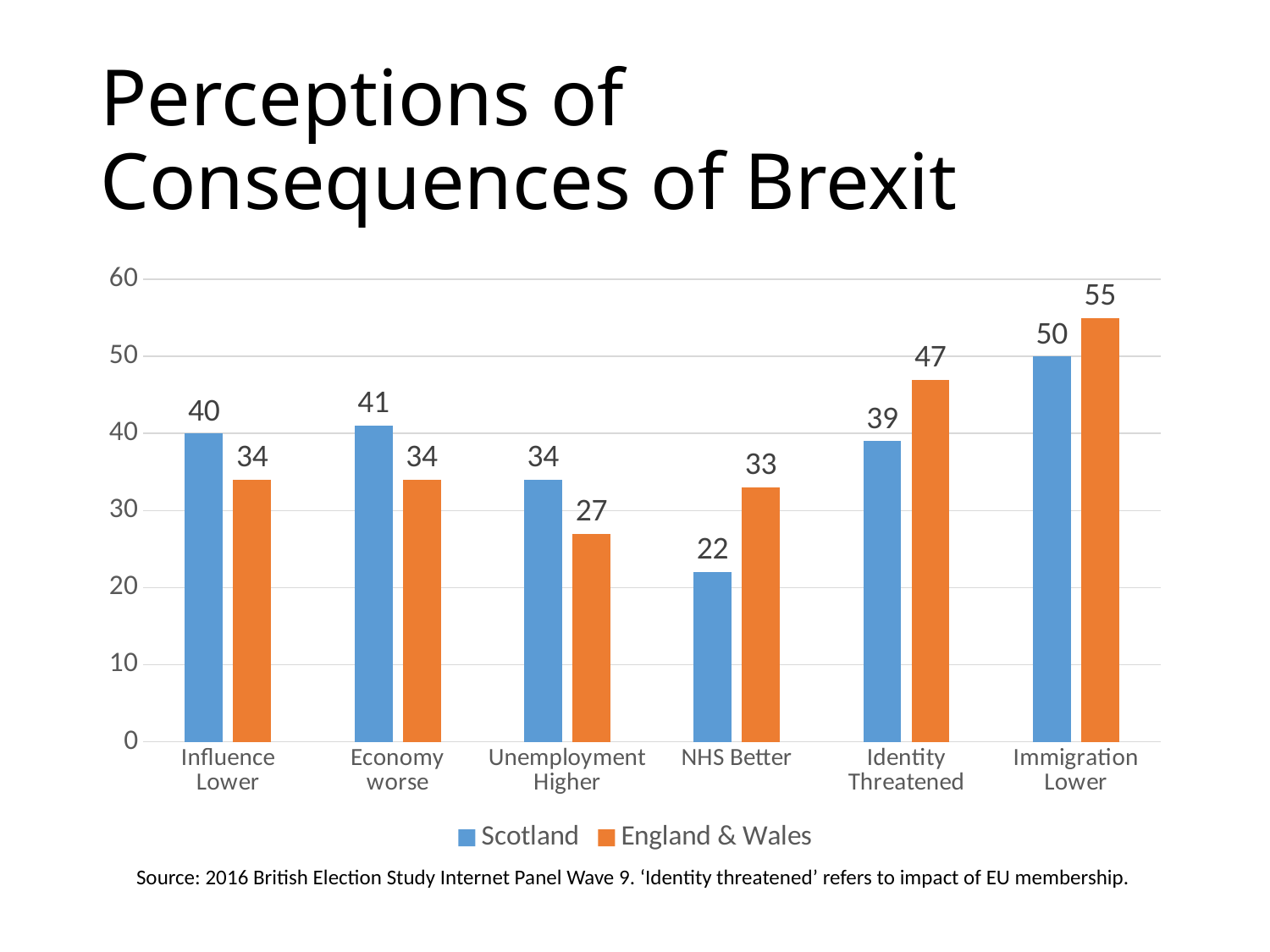
What is the value for Scotland for NHS Better? 22 What is the value for Scotland for Influence Lower? 40 How many series does the legend list? 2 Which category has the highest value for England & Wales? Immigration Lower How many categories are shown on the x axis? 6 Which is larger for Unemployment Higher: Scotland or England & Wales? Scotland Which category has the lowest value for Scotland? NHS Better Is the value for England & Wales for NHS Better greater or less than 30? greater What is the difference between England & Wales and Scotland for Immigration Lower? 5 What kind of chart is shown on the slide? Bar chart Which colour represents Scotland in the chart? Blue What is the value for England & Wales for Identity Threatened? 47